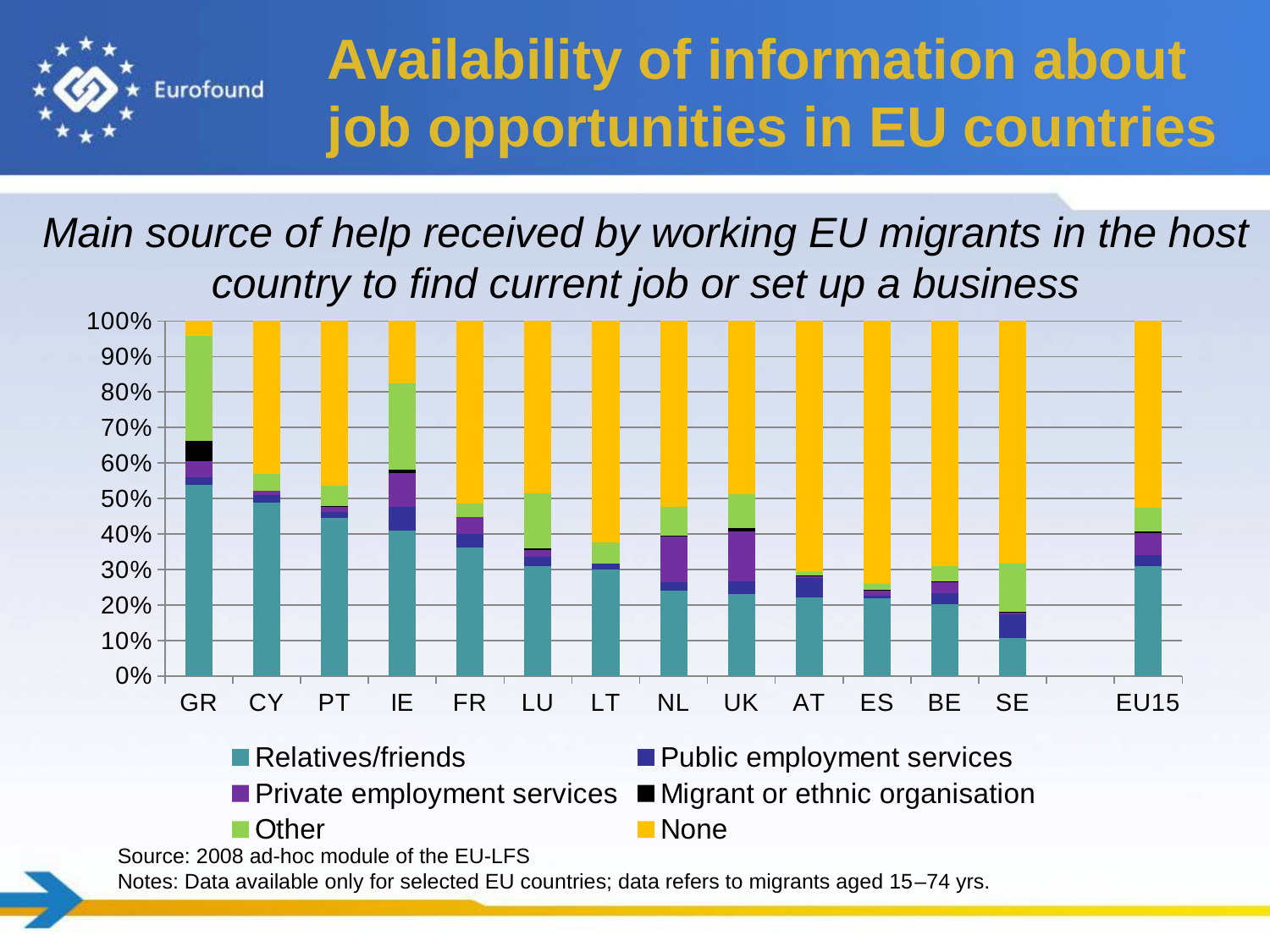
Is the Relatives/friends share for GR greater or less than 50%? greater Which legend entry is shown in yellow? None Is the Relatives/friends share for NL greater or less than 30%? less What kind of chart is shown on the slide? Stacked bar chart What is the title of the chart? Main source of help received by working EU migrants in the host country to find current job or set up a business Which country has the smallest share for None? GR Which has a larger Relatives/friends share, CY or NL? CY Is the Relatives/friends share for SE greater or less than 20%? less How many series does the chart's legend list? 6 Which country has the lowest share for Relatives/friends? SE How many countries/categories are shown along the x axis of the chart? 14 Which country has the highest share for Relatives/friends? GR